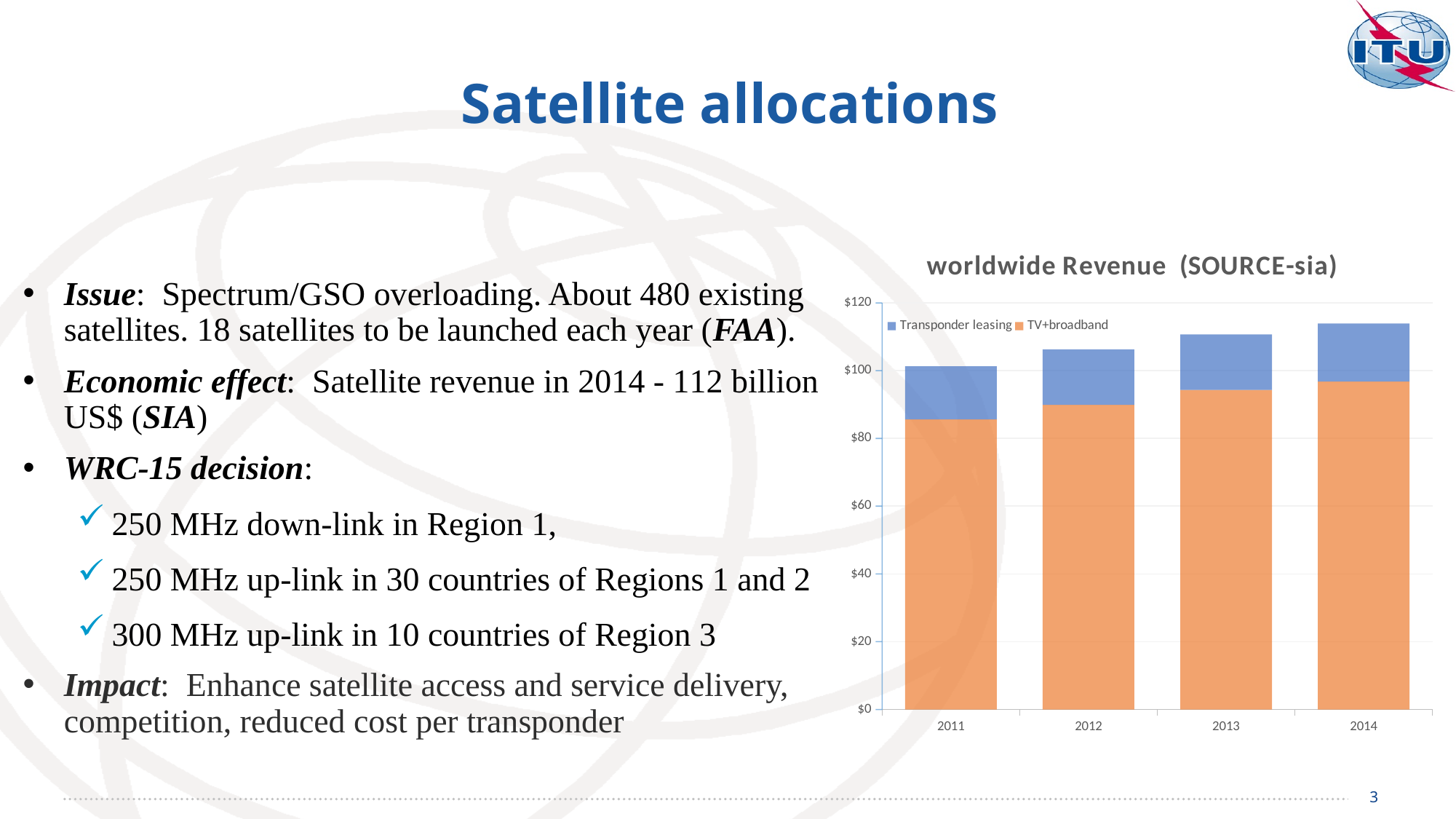
Which year has the highest total worldwide revenue in the chart? 2014 What kind of chart is shown on the slide? Stacked bar chart How many years are shown on the x axis of the chart? 4 Which series is shown in orange in the chart? TV+broadband How many series does the chart legend list? 2 Do the total revenue bars rise or fall from 2011 to 2014? Rise Is the TV+broadband value for 2011 greater or less than $80? greater What is the title of the chart? worldwide Revenue (SOURCE-sia) Which is larger, the total revenue for 2014 or for 2011? 2014 Is the total revenue bar for 2013 greater or less than $100? greater Which year has the lowest total worldwide revenue in the chart? 2011 Is the total revenue bar for 2014 greater or less than $120? less